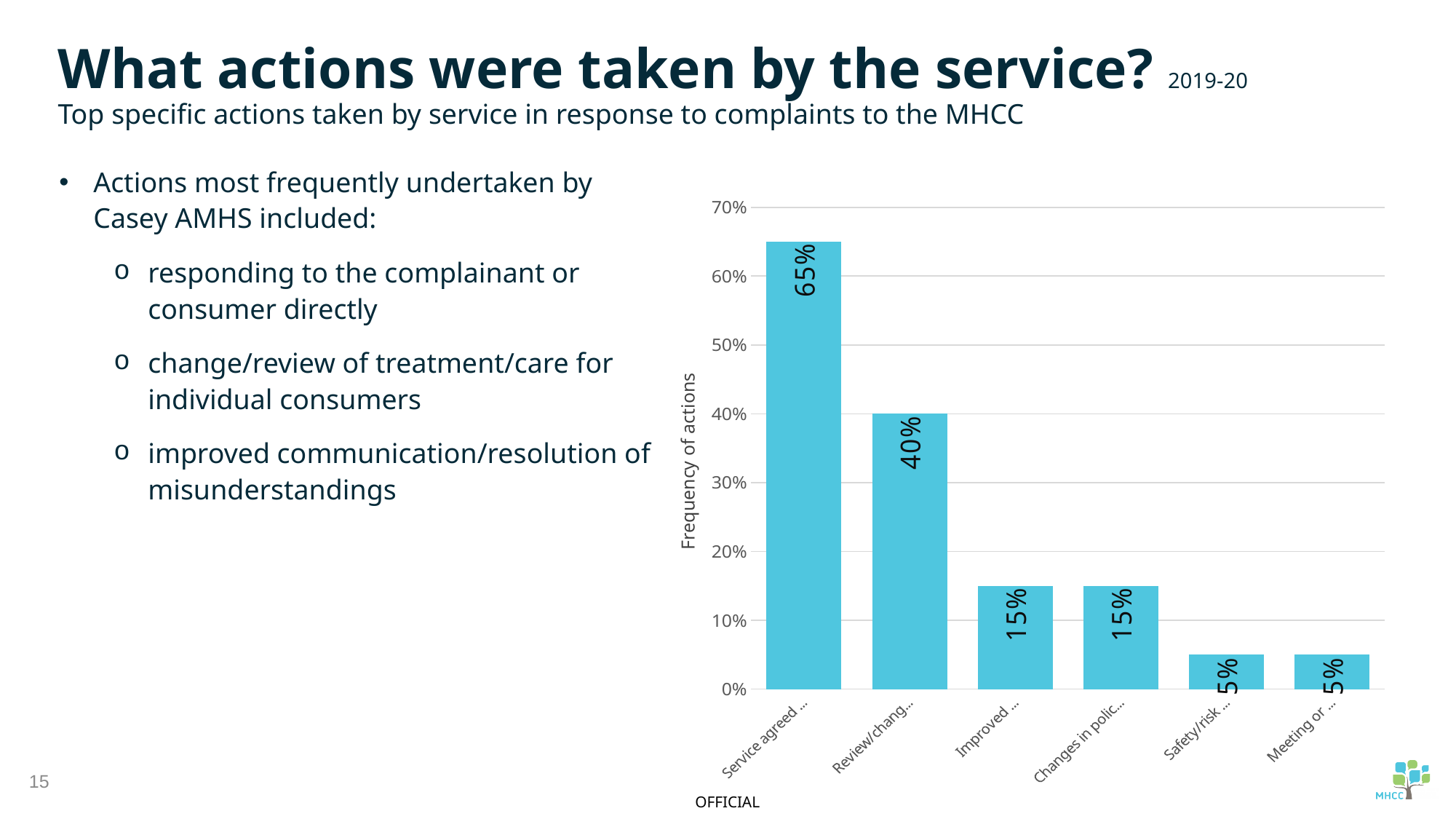
How many bars (categories) does the chart show? 6 What type of chart is shown on the slide? bar chart What is the difference between the first bar ("Service agreed ...") and the second bar ("Review/chang...")? 25% What is the value of the bar whose label begins "Service agreed"? 65% Which is larger: the bar labelled "Review/chang..." or the bar labelled "Improved ..."? Review/chang... What is the value of the bar whose label begins "Safety/risk"? 5% What is the value of the bar whose label begins "Review/chang"? 40% What is the value of the bar whose label begins "Changes in polic"? 15% What is the label on the vertical axis of the chart? Frequency of actions Do the bar values rise or fall from left to right along the x axis? fall Which category has the highest value in the chart? Service agreed ... Is the value of the bar labelled "Service agreed ..." greater or less than 60%? greater